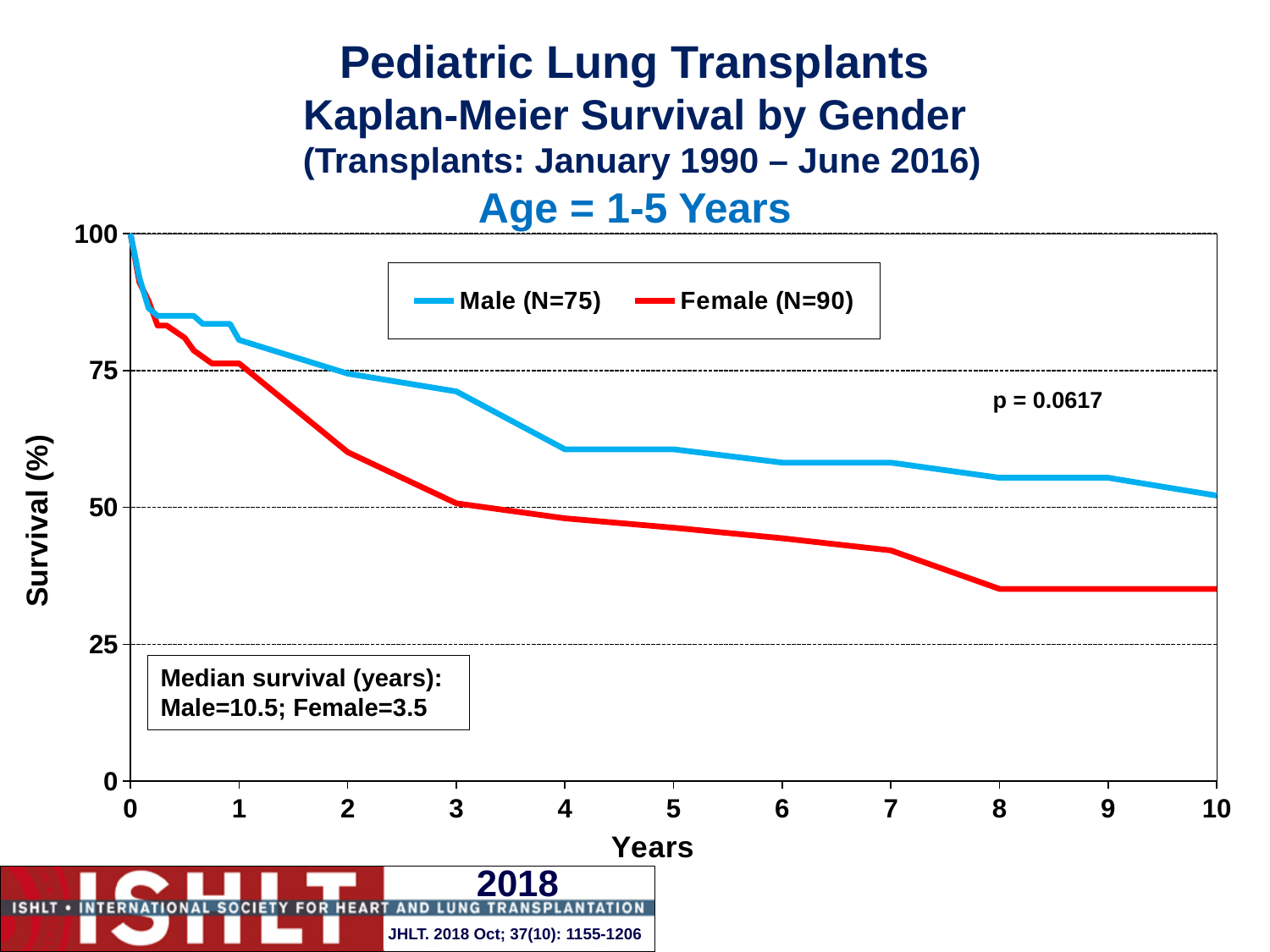
What p-value is shown on the chart? p = 0.0617 At 5 years, which group has higher survival, Male or Female? Male Is the Female survival value at 10 years greater or less than 50? less Is the Female survival value at 8 years greater or less than 50? less Do the survival curves rise or fall as years increase? fall Is the Male survival value at 10 years greater or less than 50? greater What kind of chart is shown on the slide? line chart What is the median survival in years for females according to the slide? 3.5 How many series does the legend list? 2 What is the median survival in years for males according to the slide? 10.5